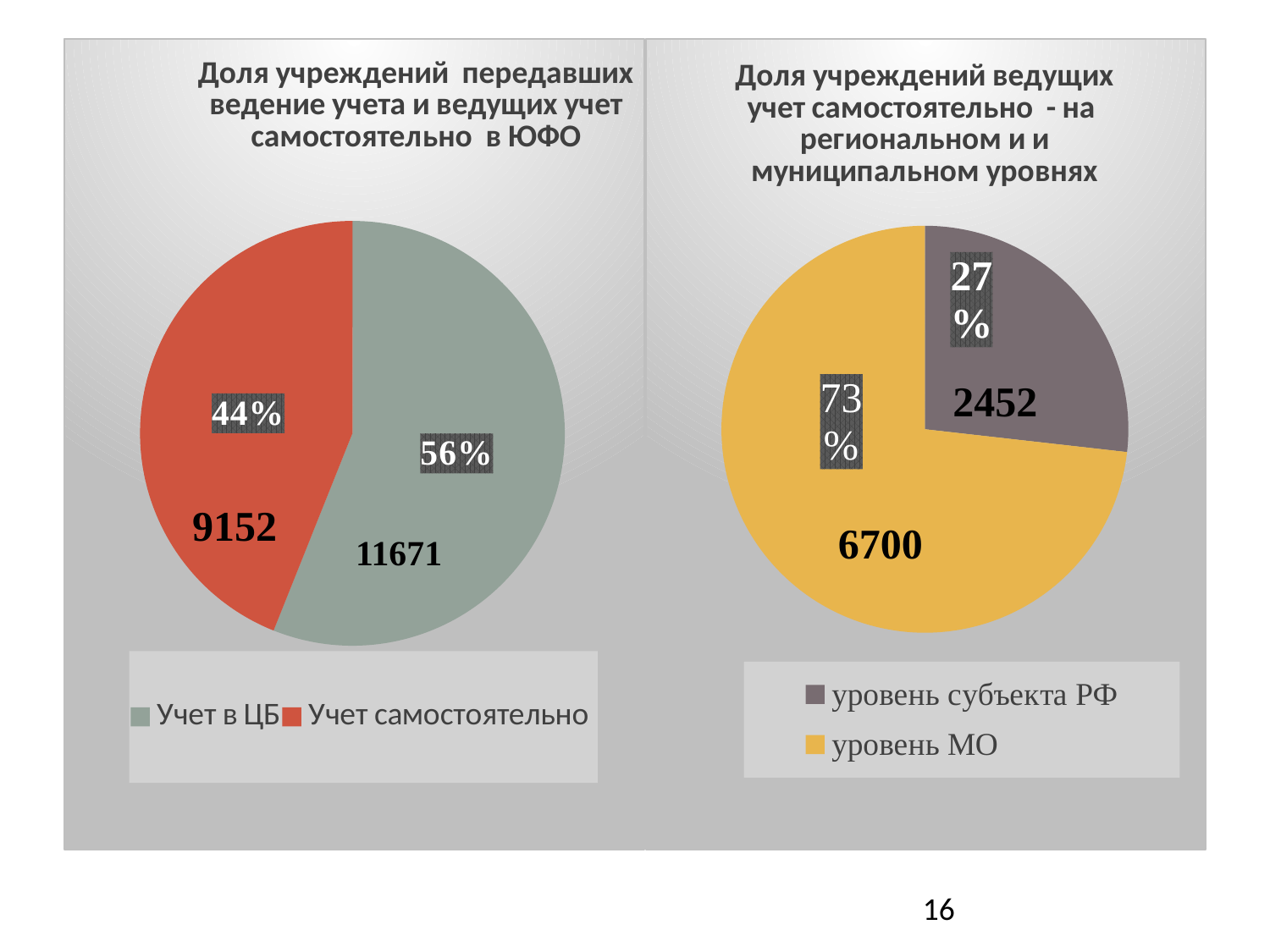
In the right chart, what share of the pie does "уровень субъекта РФ" represent? 27% In the left chart, what share of the pie does "Учет в ЦБ" represent? 56% In the left chart, which category has the larger value, "Учет в ЦБ" or "Учет самостоятельно"? Учет в ЦБ In the left chart, what is the value for "Учет самостоятельно"? 9152 In the right chart, what is the value for "уровень субъекта РФ"? 2452 In the right chart, what is the value for "уровень МО"? 6700 In the right chart, what is the total of the two slices? 9152 In the left chart, what share of the pie does "Учет самостоятельно" represent? 44% In the left chart, what is the value for "Учет в ЦБ"? 11671 In the right chart, which category has the smallest value? уровень субъекта РФ In the left chart, what is the difference between the values for "Учет в ЦБ" and "Учет самостоятельно"? 2519 What type of chart is the right chart? Pie chart